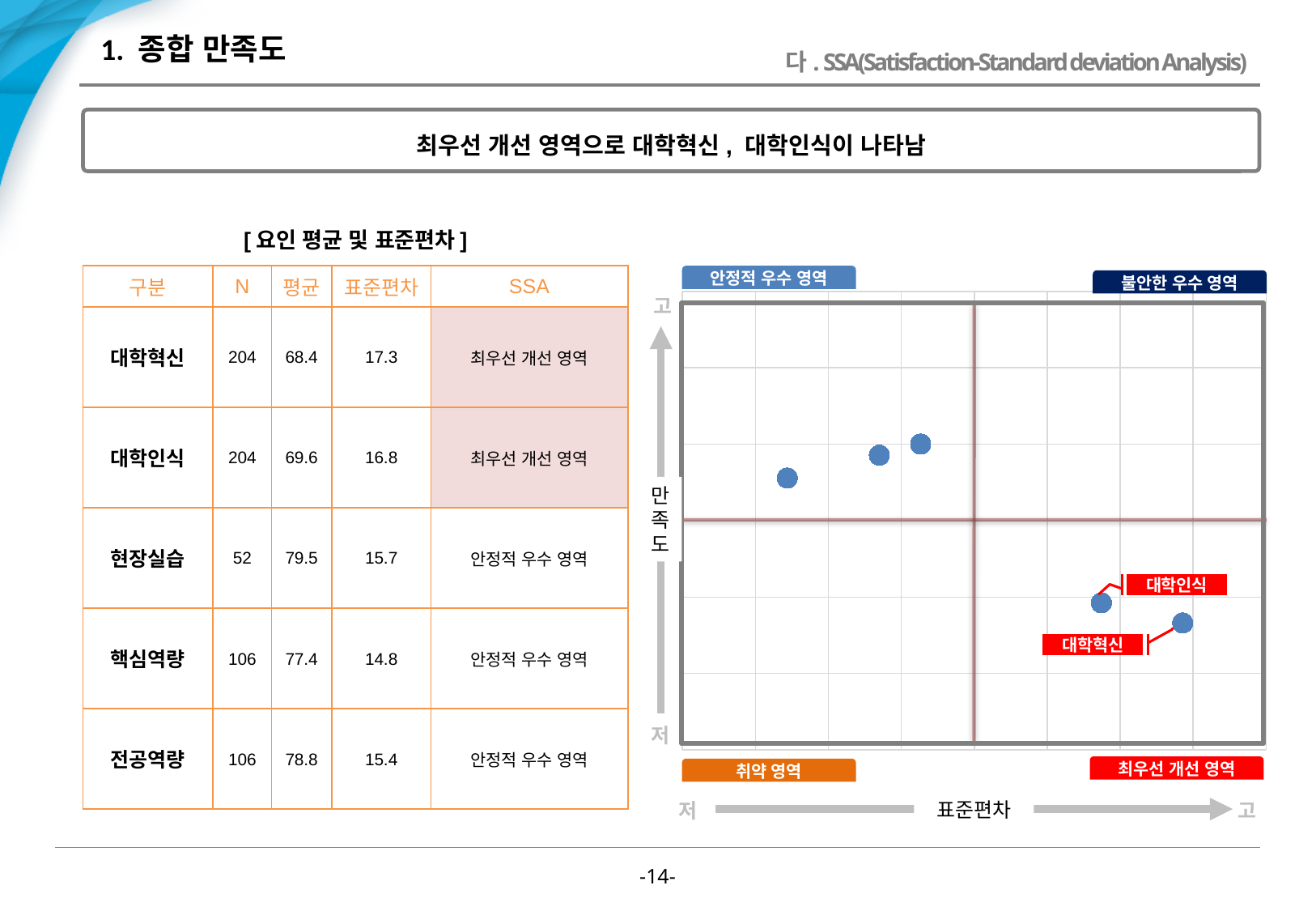
What kind of chart is shown on the right side of the slide? scatter chart How many points in the scatter chart fall in the 취약 영역 (lower-left) quadrant? 0 What is the label of the vertical axis of the scatter chart? 만족도 How many data points are plotted in the scatter chart? 5 In the scatter chart, which of the two labeled points, 대학인식 or 대학혁신, has the larger 표준편차? 대학혁신 In the scatter chart, which of the two labeled points, 대학인식 or 대학혁신, has the higher 만족도? 대학인식 In the scatter chart, is the point 대학혁신 above or below the horizontal dividing line of 만족도? below What is the label of the horizontal axis of the scatter chart? 표준편차 Which two points in the scatter chart are labeled with names? 대학인식, 대학혁신 How many points in the scatter chart fall in the 최우선 개선 영역 (lower-right) quadrant? 2 In which quadrant of the scatter chart do the points 대학혁신 and 대학인식 fall? 최우선 개선 영역